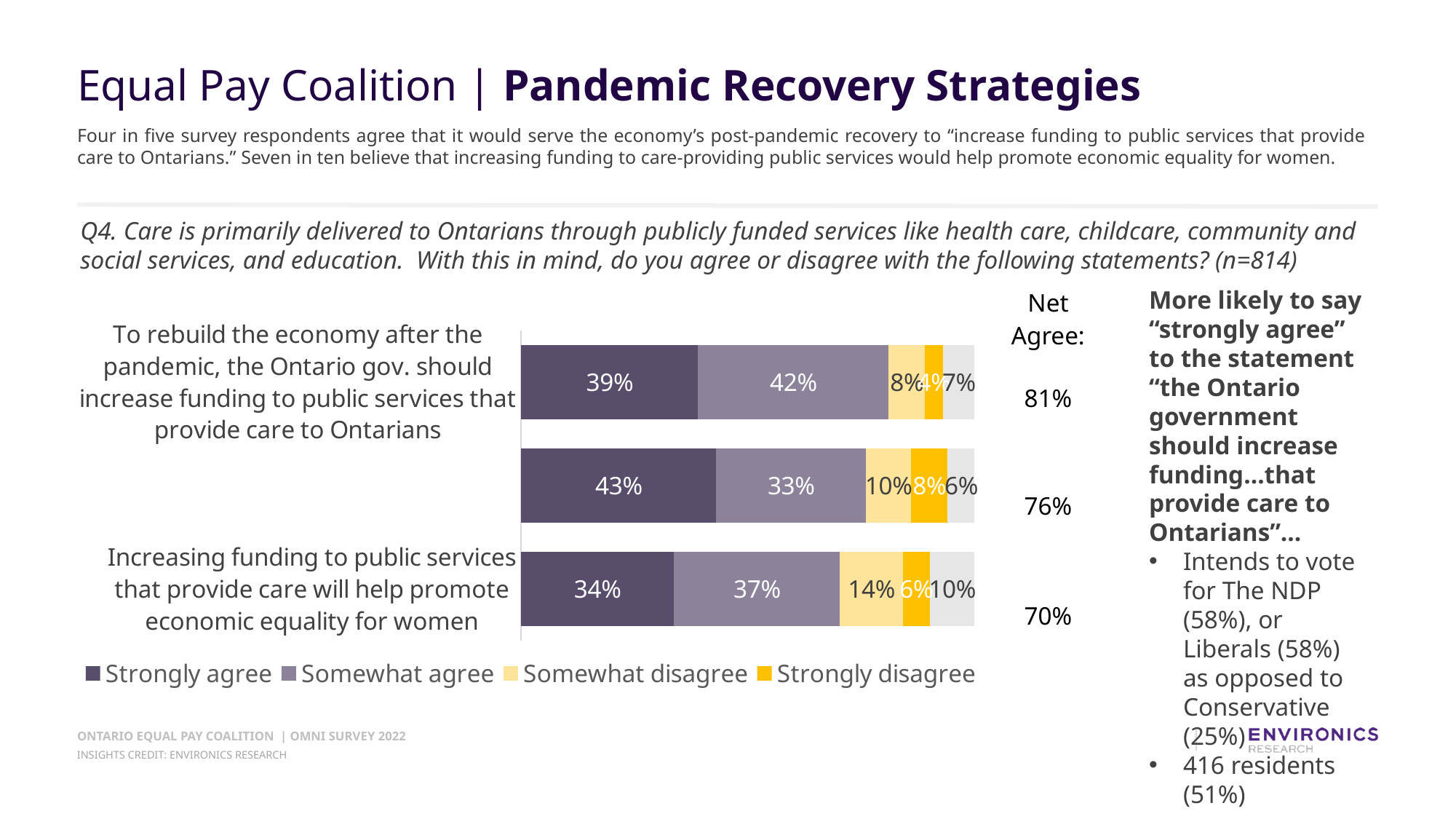
How many percentage points higher is Strongly agree for the rebuild-the-economy statement than for the economic-equality-for-women statement? 5 percentage points What is the combined Strongly agree and Somewhat agree share for the statement about rebuilding the economy after the pandemic? 81% Which response category is the largest segment in the bar for the statement about rebuilding the economy after the pandemic? Somewhat agree Which legend category has the smallest labelled segment in the bar for the statement about economic equality for women? Strongly disagree What type of chart is used on this slide? Stacked bar chart How many response categories does the chart legend list? 4 What is the Somewhat disagree value for the statement about promoting economic equality for women? 14% What is the Strongly disagree value for the statement about rebuilding the economy after the pandemic? 4% What percentage of respondents strongly agree that the Ontario government should increase funding to public services that provide care to Ontarians to rebuild the economy after the pandemic? 39% What is the Net Agree value shown for the statement that increasing funding to care-providing public services will help promote economic equality for women? 70% What percentage somewhat agree that increasing funding to public services that provide care will help promote economic equality for women? 37% Which statement has the larger Somewhat agree share: the one about rebuilding the economy after the pandemic or the one about economic equality for women? Rebuilding the economy after the pandemic